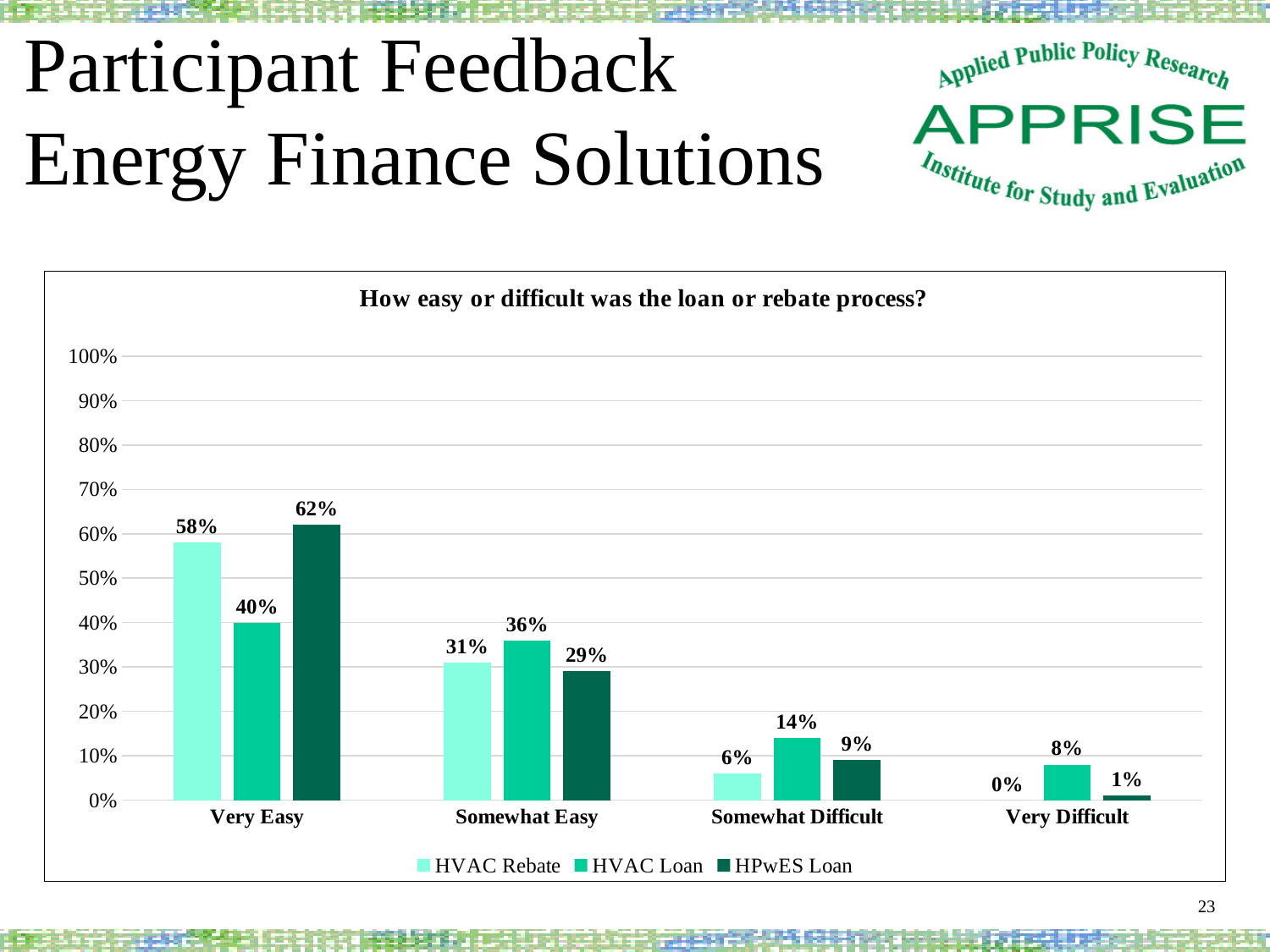
What percentage of HPwES Loan participants said the process was Somewhat Easy? 29% What percentage of HVAC Loan participants said the process was Somewhat Difficult? 14% Which series has the lowest value in the Very Difficult category? HVAC Rebate How many series does the legend list? 3 What is the difference between the HPwES Loan and HVAC Loan values for Very Easy? 22% Which is larger for Somewhat Easy: HVAC Rebate or HVAC Loan? HVAC Loan What percentage of HVAC Rebate participants said the process was Very Easy? 58% What kind of chart is shown on the slide? bar chart How many response categories are shown on the x axis? 4 Which series has the highest value in the Very Easy category? HPwES Loan What is the title of the chart? How easy or difficult was the loan or rebate process? Is the HVAC Loan value for Very Easy greater or less than 50%? less